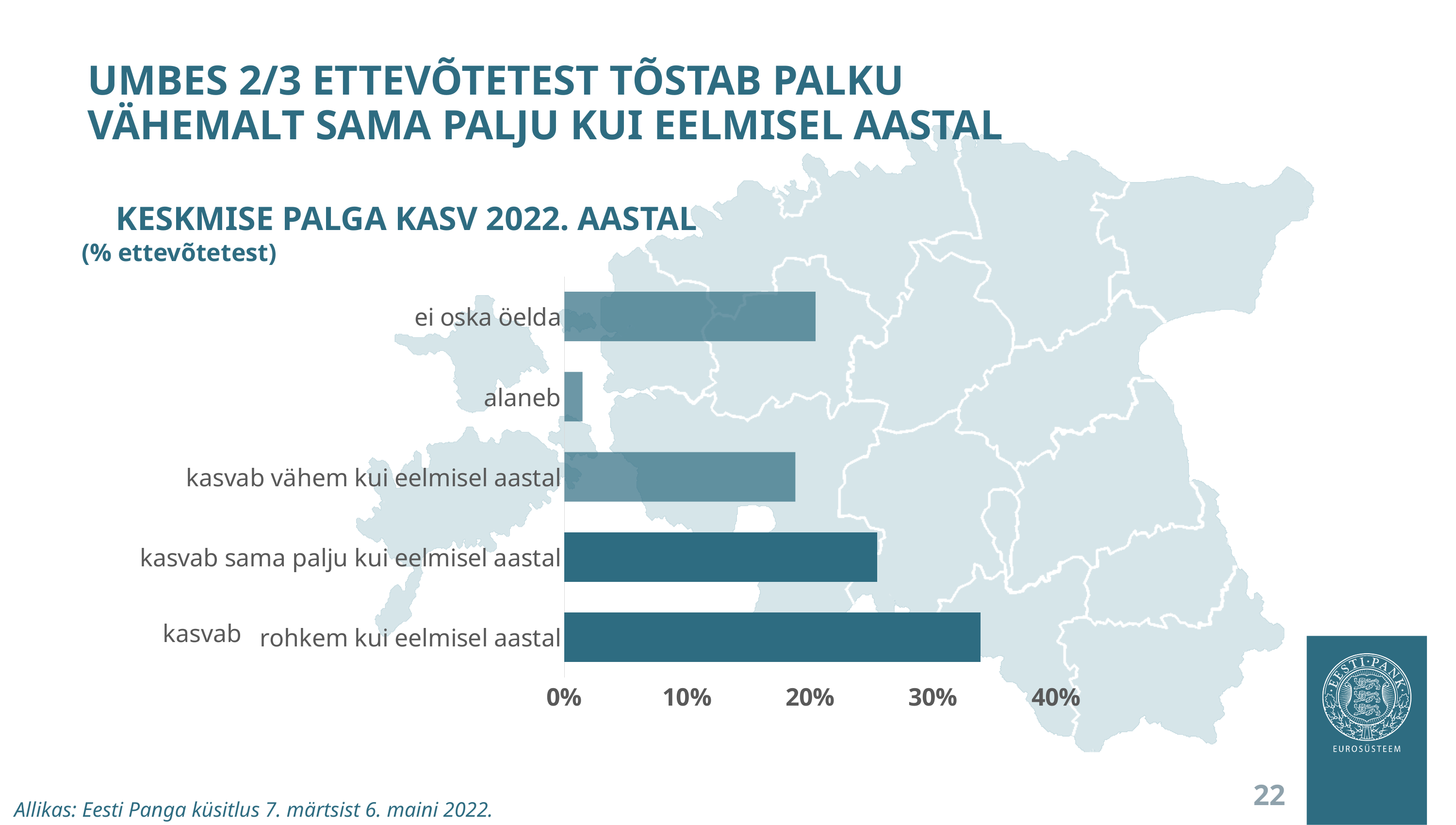
Is the value for 'kasvab rohkem kui eelmisel aastal' greater or less than 30%? greater Is the value for 'alaneb' greater or less than 10%? less Which category has the lowest value? alaneb Which is larger: the value for 'kasvab sama palju kui eelmisel aastal' or for 'kasvab vähem kui eelmisel aastal'? kasvab sama palju kui eelmisel aastal In what unit are the chart's values expressed, according to the subtitle? % ettevõtetest How many categories are shown in the chart? 5 What kind of chart is shown on the slide? bar chart Is the value for 'kasvab vähem kui eelmisel aastal' greater or less than 10%? greater What is the title of the chart? KESKMISE PALGA KASV 2022. AASTAL Which category has the highest value? kasvab rohkem kui eelmisel aastal